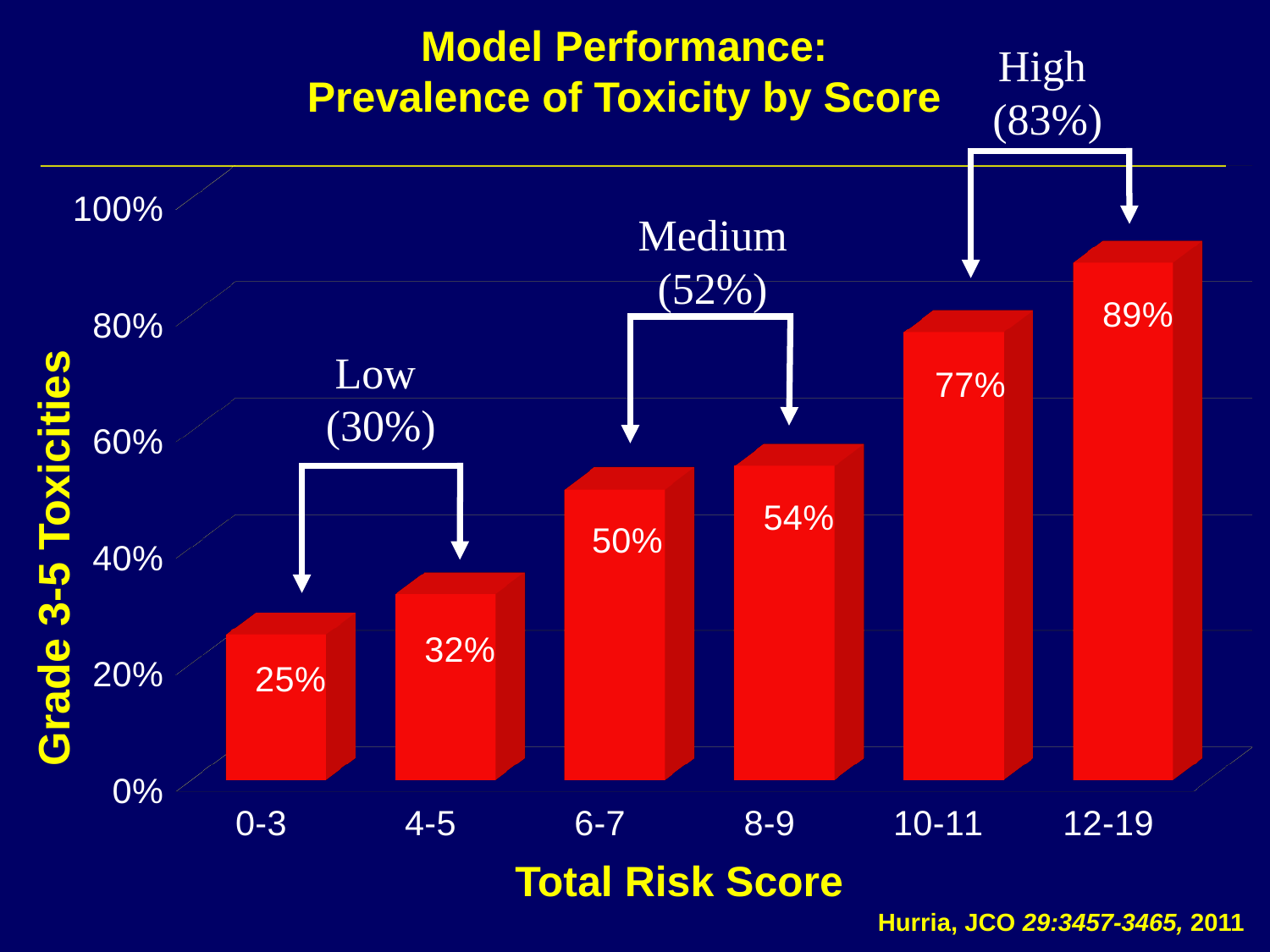
What prevalence is given for the Medium risk category annotation? 52% What is the value shown for the 8-9 risk score group? 54% What is the difference between the values for the 4-5 and 0-3 risk score groups? 7% Which total risk score group has the lowest prevalence of grade 3-5 toxicities? 0-3 What is the difference between the values for the 12-19 and 10-11 risk score groups? 12% Do the values rise or fall as the total risk score increases along the x axis? Rise How many total risk score groups are shown on the x axis? 6 What kind of chart is shown on the slide? Bar chart What is the value shown for the 10-11 risk score group? 77% Which has a higher value, the 6-7 group or the 8-9 group? 8-9 Which total risk score group has the highest prevalence of grade 3-5 toxicities? 12-19 What is the prevalence of grade 3-5 toxicities for a total risk score of 0-3? 25%